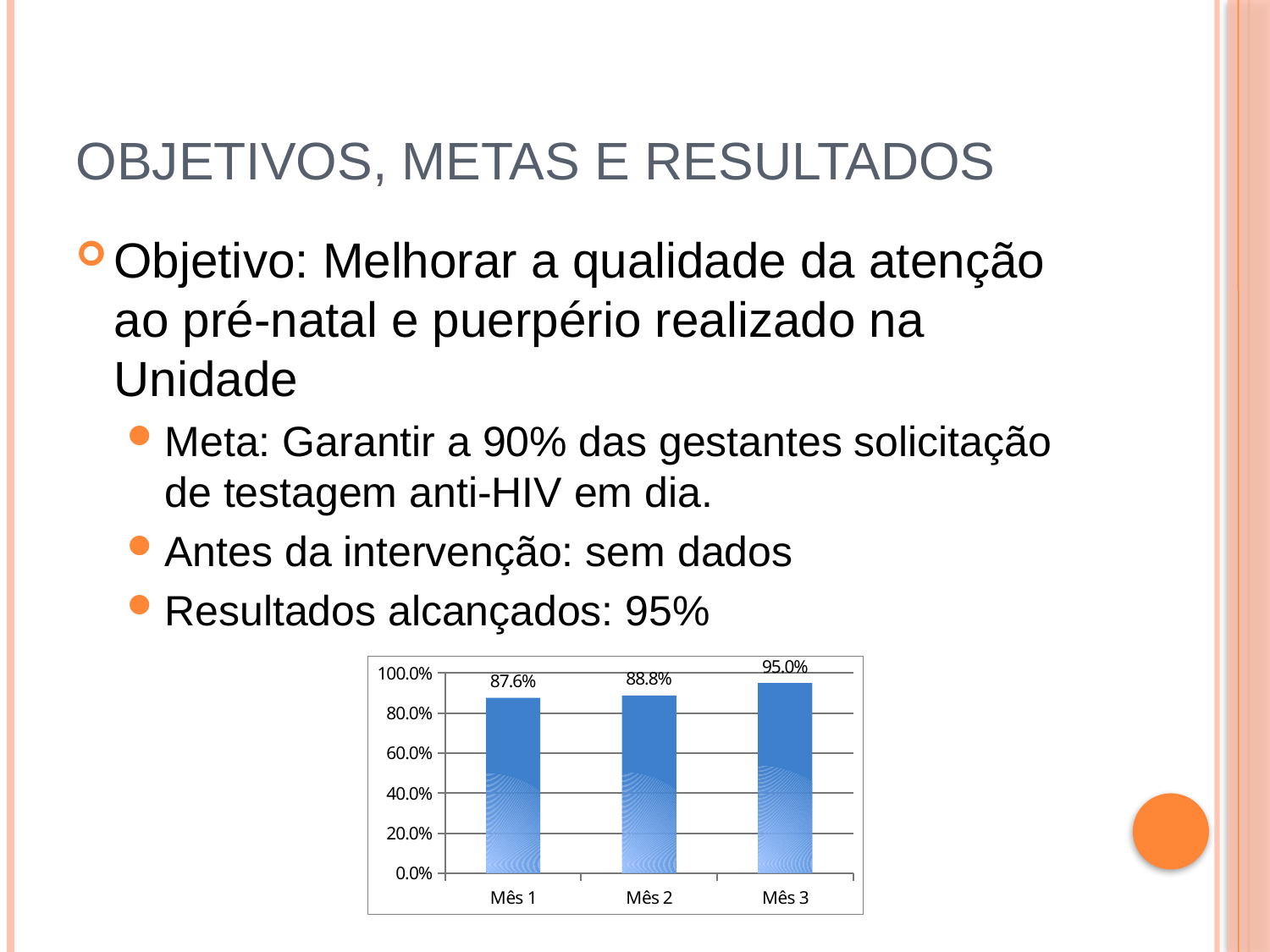
What is the difference between the values for Mês 2 and Mês 1? 1.2% What is the value for Mês 2? 88.8% What is the difference between the values for Mês 3 and Mês 1? 7.4% How many categories are shown on the x axis? 3 What is the value for Mês 3? 95.0% Which month has the lowest value? Mês 1 What kind of chart is shown on the slide? bar chart What is the value for Mês 1? 87.6% Do the values rise or fall from Mês 1 to Mês 3? rise Is the value for Mês 1 greater or less than 80.0%? greater Which month has the highest value? Mês 3 Which is larger, the value for Mês 3 or the value for Mês 2? Mês 3